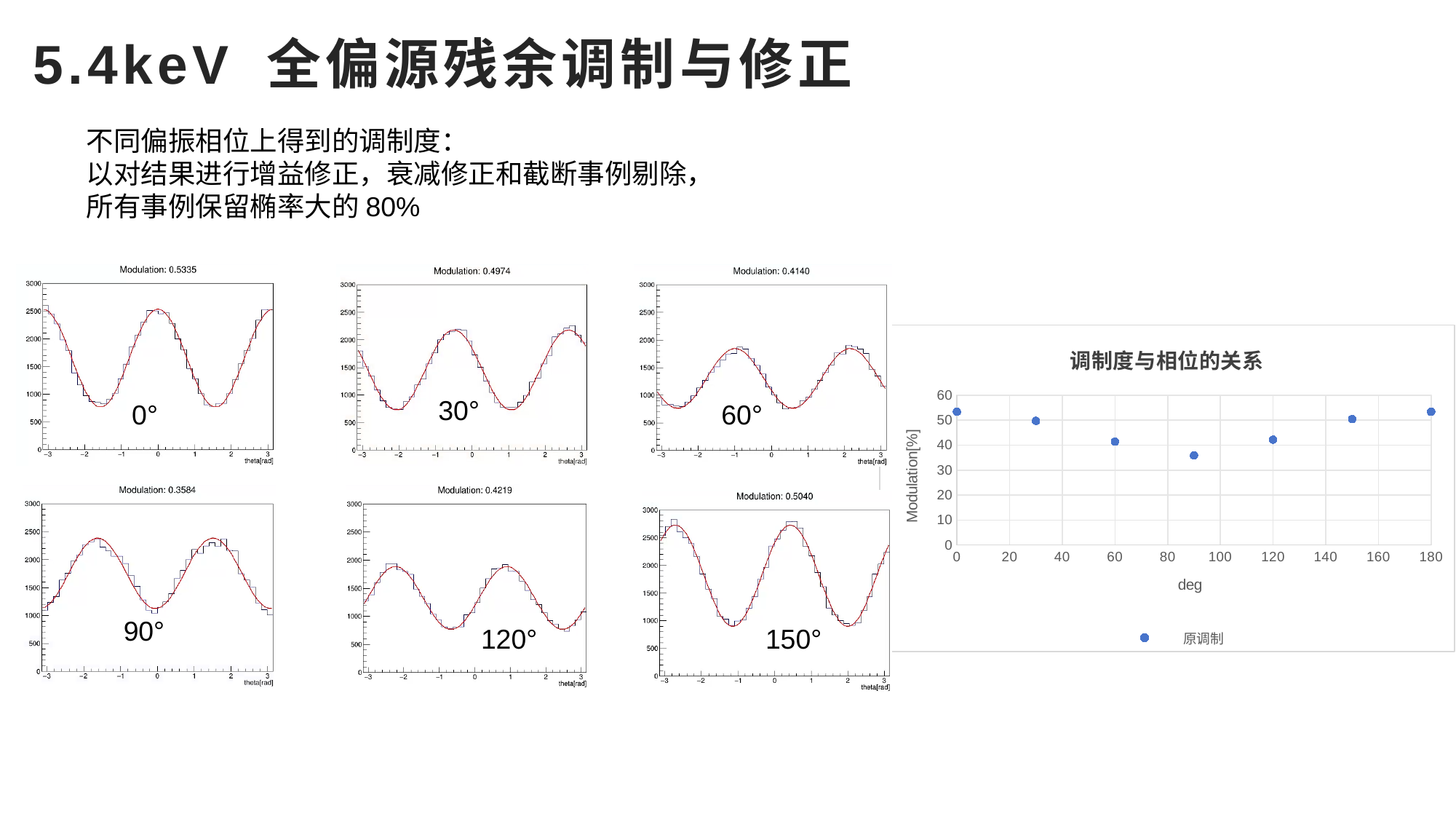
In the chart titled 调制度与相位的关系, at which deg value is the modulation lowest? 90 In the chart titled 调制度与相位的关系, is the value at 0 deg greater or less than 50? greater In the chart titled 调制度与相位的关系, is the value at 90 deg greater or less than 40? less What is the difference between the printed modulation values of the 0° plot and the 90° plot? 0.1751 In the small plot labelled 90°, what modulation value is printed in its title? 0.3584 In the chart titled 调制度与相位的关系, how many data points are plotted? 7 In the chart titled 调制度与相位的关系, is the value at 150 deg greater or less than 40? greater What kind of chart is the chart titled 调制度与相位的关系? scatter chart In the chart titled 调制度与相位的关系, what is the legend entry for the plotted series? 原调制 Among the six small modulation plots, which phase label has the highest printed modulation value? 0° In the chart titled 调制度与相位的关系, how many series does the legend list? 1 In the small plot labelled 0°, what modulation value is printed in its title? 0.5335